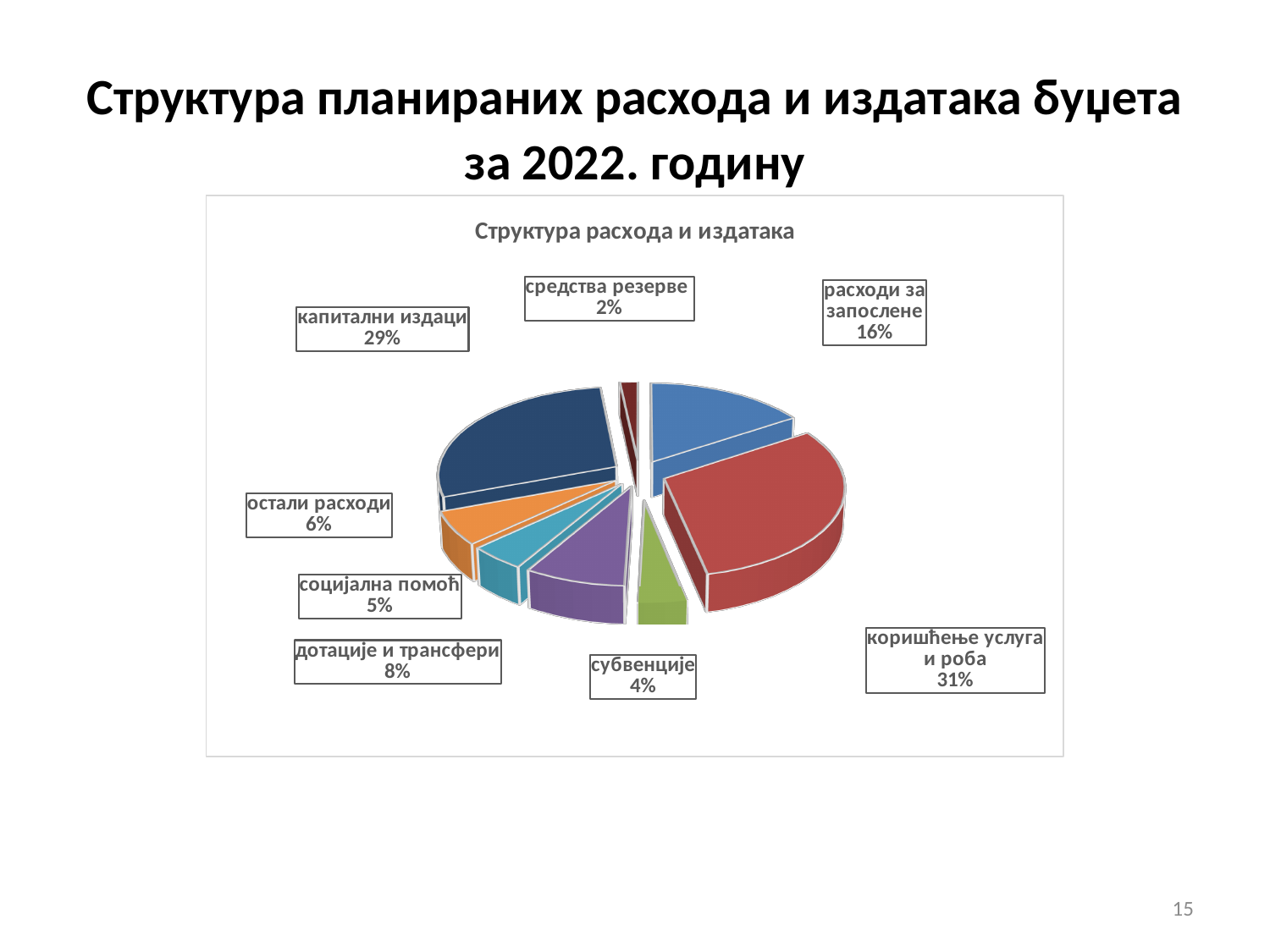
What kind of chart is shown on the slide? Pie chart What percentage is shown for расходи за запослене? 16% What percentage is shown for средства резерве? 2% Which is larger, the share for социјална помоћ or the share for остали расходи? остали расходи Which category has the smallest share of the pie? средства резерве What percentage is shown for дотације и трансфери? 8% What is the title of the chart? Структура расхода и издатака Which category has the largest share of the pie? коришћење услуга и роба How many slices does the pie chart have? 8 What share of the pie is labelled for коришћење услуга и роба? 31% What is the difference in percentage points between коришћење услуга и роба and капитални издаци? 2 What share of the pie is labelled for капитални издаци? 29%